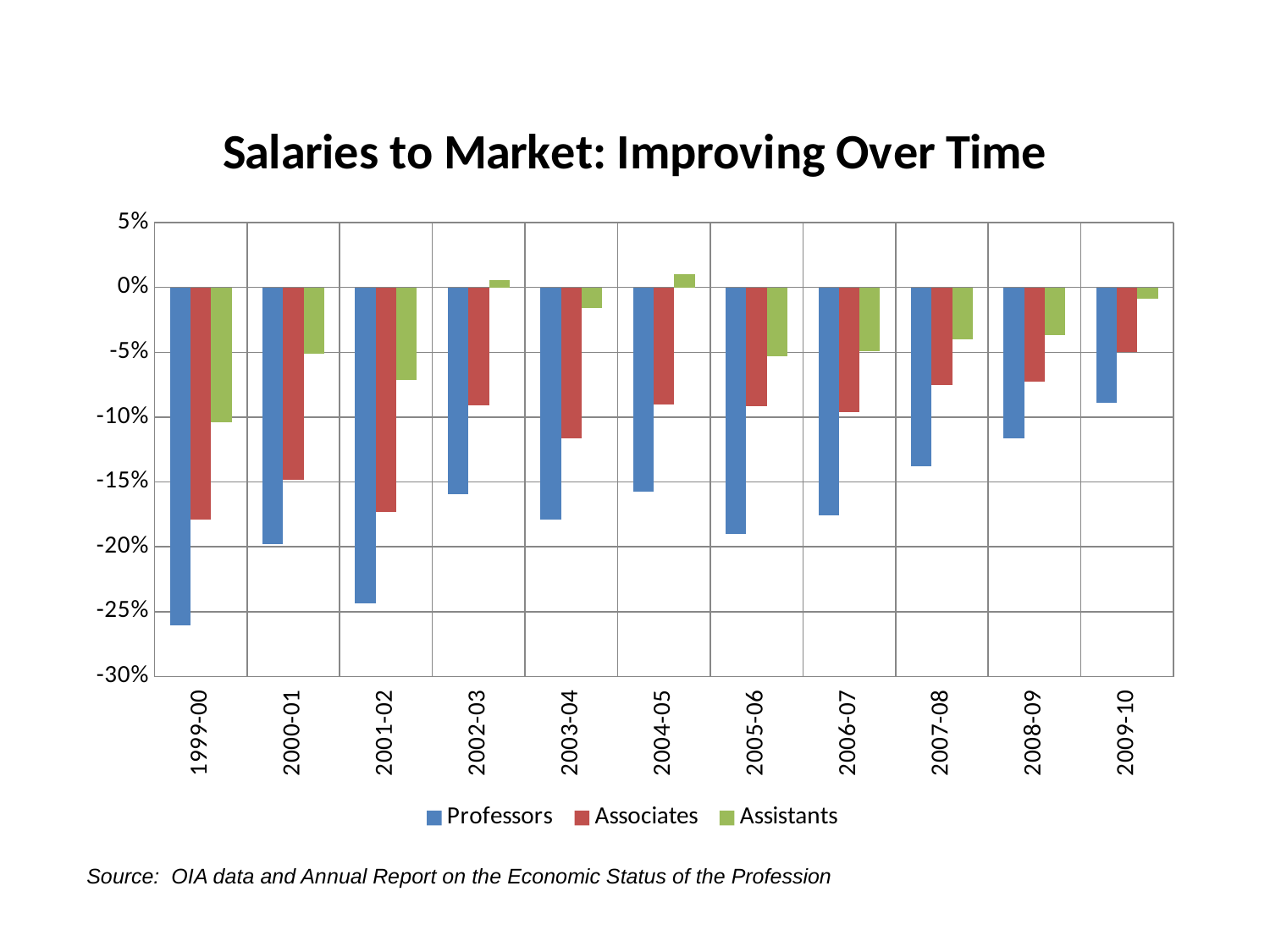
How many series does the legend list? 3 Is the value for Associates in 2009-10 greater or less than -10%? greater How many academic years are shown on the x axis? 11 In which year is the Professors value lowest? 1999-00 What type of chart is shown on the slide? bar chart Is the value for Assistants in 2001-02 greater or less than -5%? less In 2009-10, which is larger: the value for Professors or the value for Associates? Associates Is the value for Professors in 2009-10 greater or less than -10%? greater Do the Professors values generally rise or fall from 1999-00 to 2009-10? rise What is the title of the chart? Salaries to Market: Improving Over Time In which year is the Assistants value lowest? 1999-00